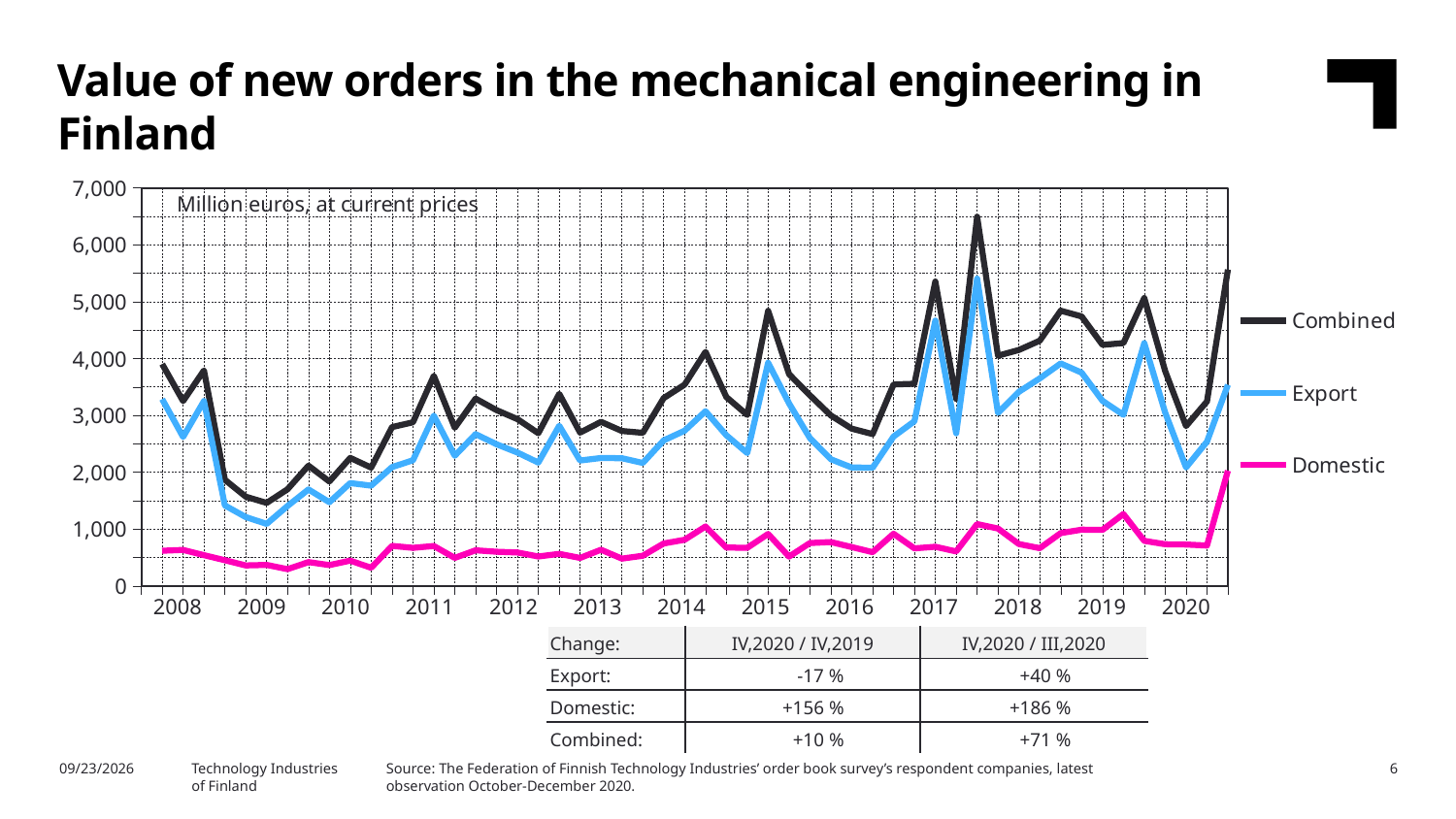
Which series has the highest values throughout the chart? Combined How many years are labelled on the x axis? 13 Does the Combined series rise or fall from the start of 2008 to 2009? fall Which series has the lowest values throughout the chart? Domestic Is the value of the Domestic series at the start of 2008 greater or less than 1,000? less What are the three series named in the legend? Combined, Export, Domestic Is the lowest value of the Export series in 2009 greater or less than 2,000? less What kind of chart is shown on the slide? Line chart Is the peak value of the Combined series in 2017 greater or less than 6,000? greater According to the table, what is the Export change for IV,2020 / IV,2019? -17 % How many series does the legend list? 3 What unit is stated in the label inside the chart area? Million euros, at current prices